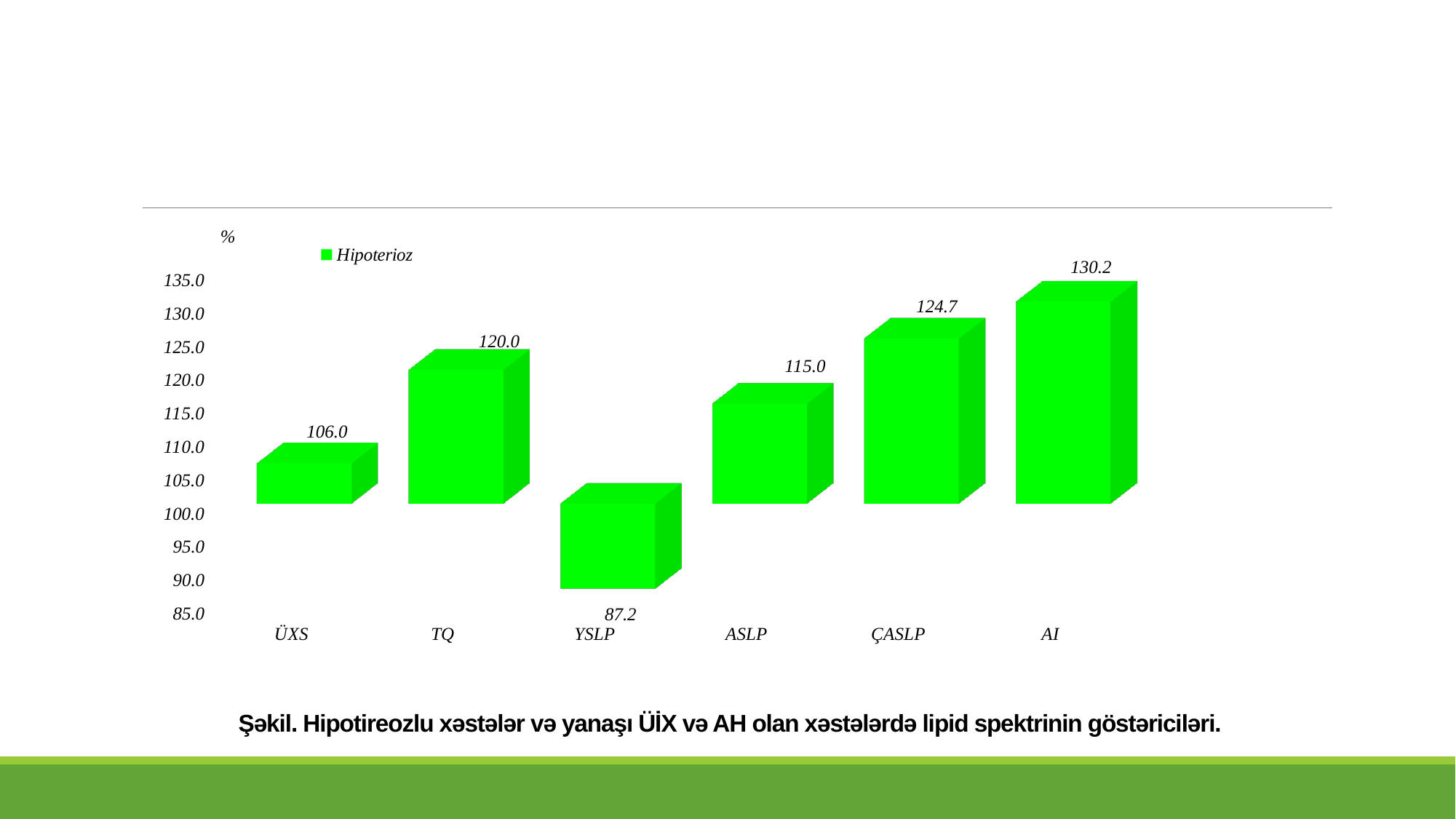
What is the value for YSLP? 87.2 Which is larger, the value for ASLP or the value for TQ? TQ What is the value for TQ? 120.0 What is the value for AI? 130.2 Which category has the lowest value? YSLP What is the difference between the values for AI and ÜXS? 24.2 What kind of chart is shown on the slide? bar chart What series name does the legend show? Hipoterioz How many categories are shown on the x axis? 6 Which category has the highest value? AI What is the value for ÇASLP? 124.7 Is the value for ÜXS greater or less than 110.0? less